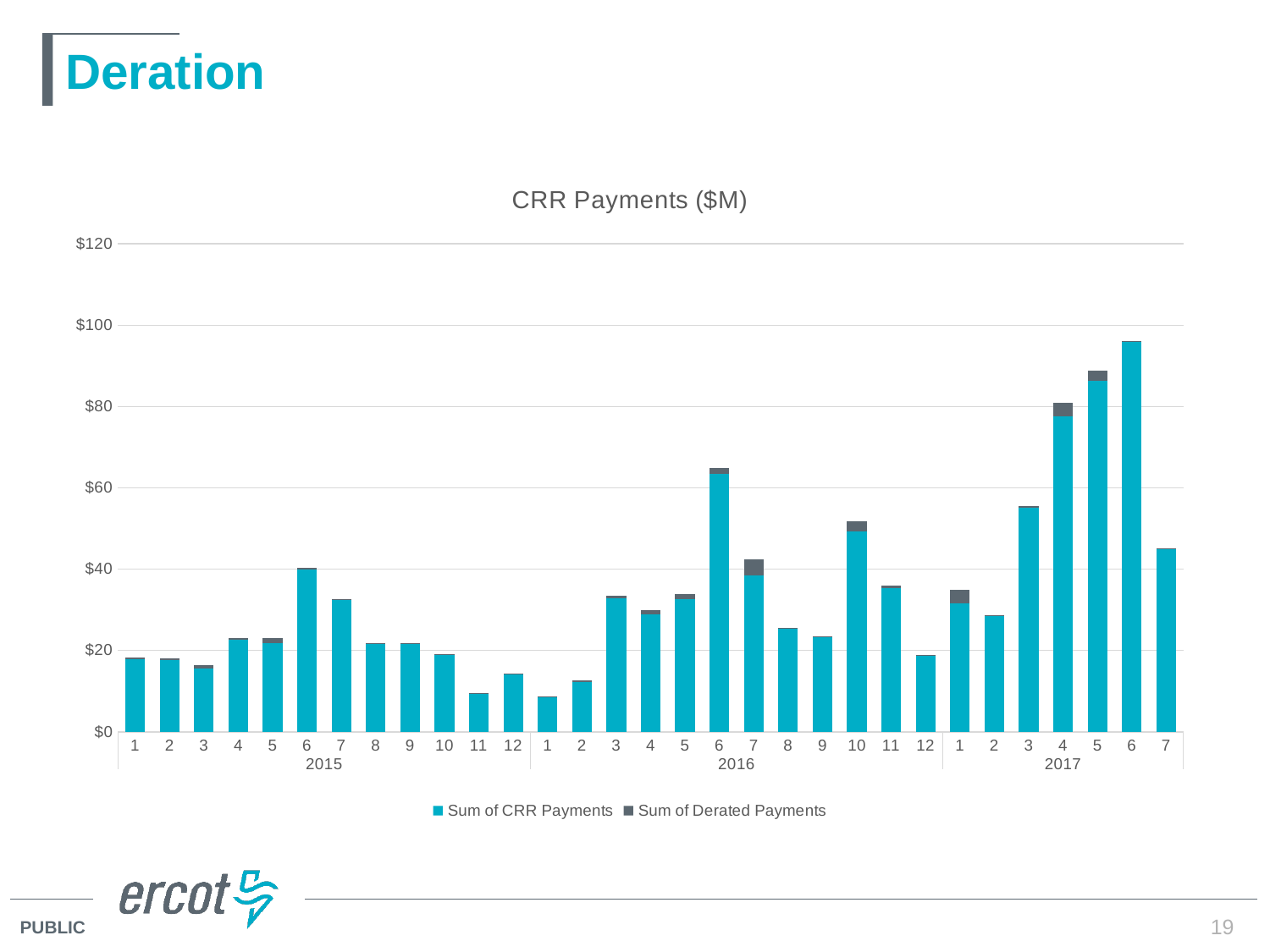
Is the total for month 1 of 2015 greater or less than $20? less What kind of chart is shown on the slide? Stacked bar chart Is the total for month 6 of 2017 greater or less than $80? greater Which is larger, the total for month 6 of 2016 or month 10 of 2016? Month 6 of 2016 Do the totals rise or fall from month 1 to month 6 of 2017? Rise How many series does the legend list? 2 Which month has the highest total CRR Payments? Month 6 of 2017 What is the title of the chart? CRR Payments ($M) Is the total for month 6 of 2016 greater or less than $60? greater How many monthly bars are plotted in the chart? 31 Which is larger, the total for month 4 of 2017 or month 5 of 2017? Month 5 of 2017